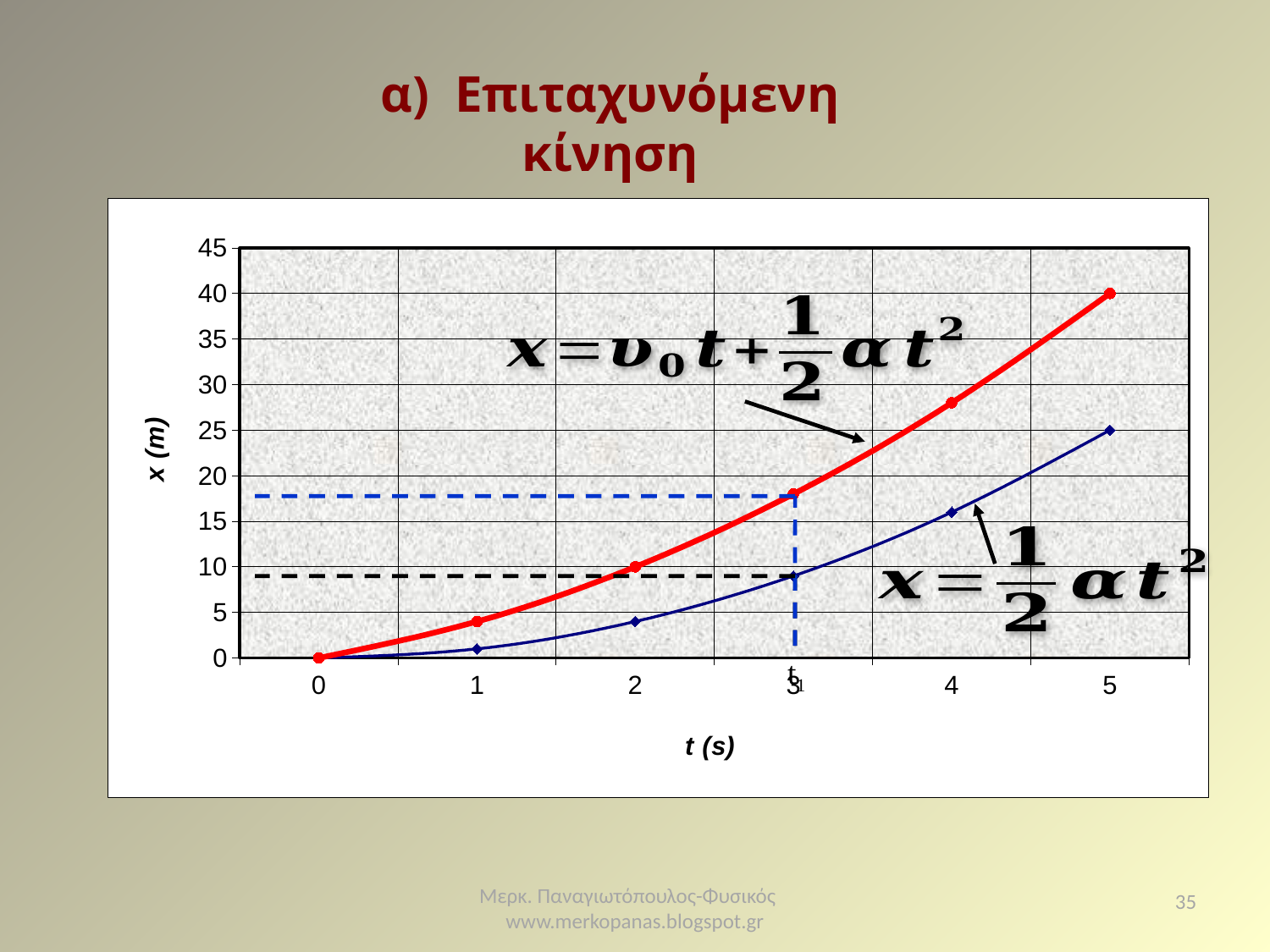
What type of chart is shown on the slide? line chart How many data points are plotted on the red curve? 6 What is the value of the red curve at t = 2 s? 10 What is the label of the vertical axis? x (m) What is the difference between the red curve and the blue curve at t = 5 s? 15 What is the value of the blue curve at t = 5 s? 25 Is the value of the red curve at t = 4 s greater or less than 25? greater Is the value of the blue curve at t = 4 s greater or less than 15? greater Is the value of the blue curve at t = 3 s greater or less than 10? less Do the values of the red curve rise or fall as t increases? rise What is the value of the red curve at t = 5 s? 40 At t = 5 s, which curve has the larger value, the red one or the blue one? red